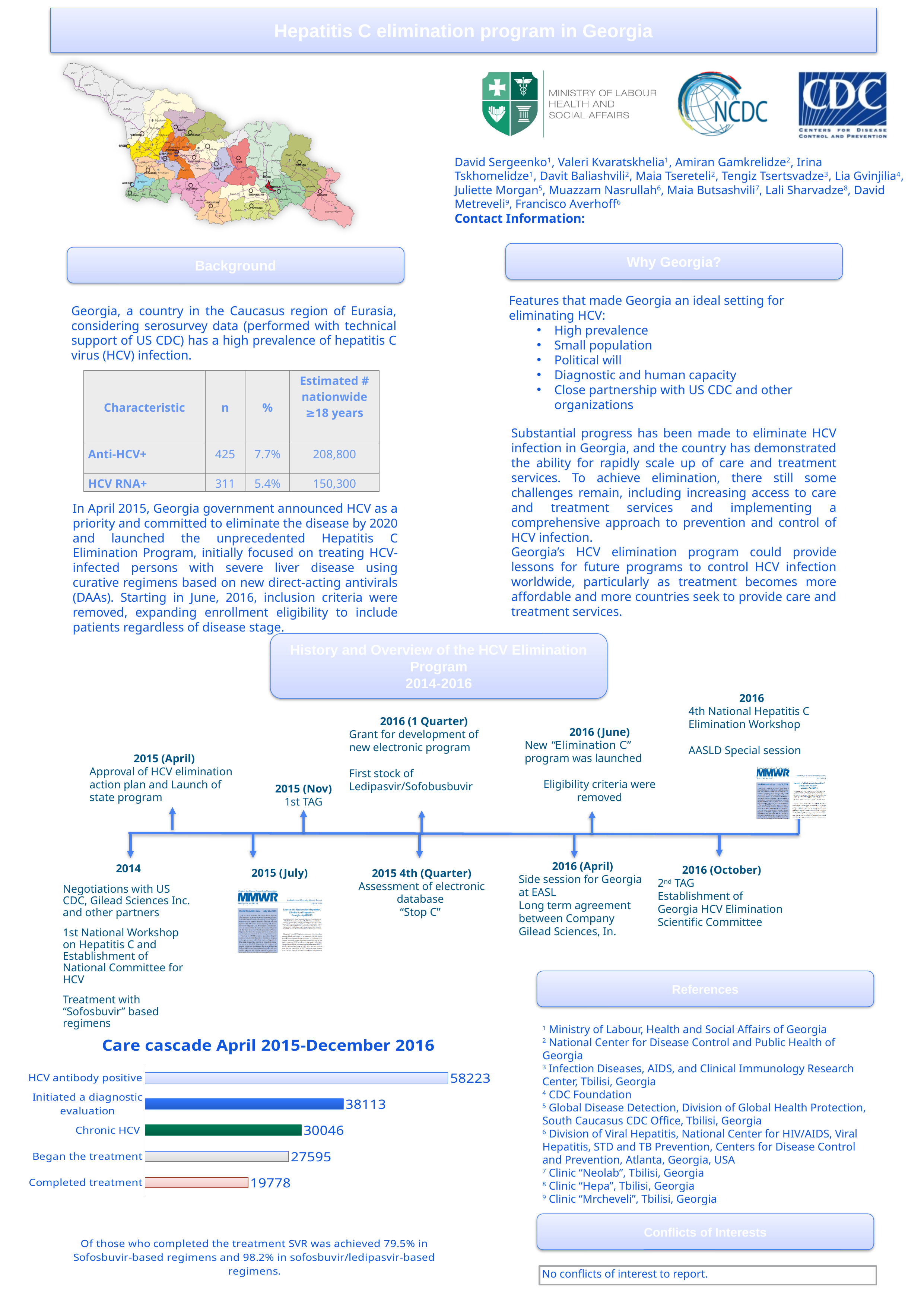
What is the difference between HCV antibody positive and Initiated a diagnostic evaluation in the Care cascade chart? 20110 What is the value for HCV antibody positive in the Care cascade April 2015-December 2016 chart? 58223 What is the title of the bar chart on the slide? Care cascade April 2015-December 2016 What type of chart is the Care cascade April 2015-December 2016 chart? Bar chart Which category has the highest value in the Care cascade chart? HCV antibody positive Which category has the lowest value in the Care cascade chart? Completed treatment How many categories are shown in the Care cascade chart? 5 What is the value for Chronic HCV in the Care cascade chart? 30046 What is the difference between Began the treatment and Completed treatment in the Care cascade chart? 7817 What is the value for Began the treatment in the Care cascade chart? 27595 What is the value for Completed treatment in the Care cascade chart? 19778 In the Care cascade chart, which is larger: Chronic HCV or Began the treatment? Chronic HCV